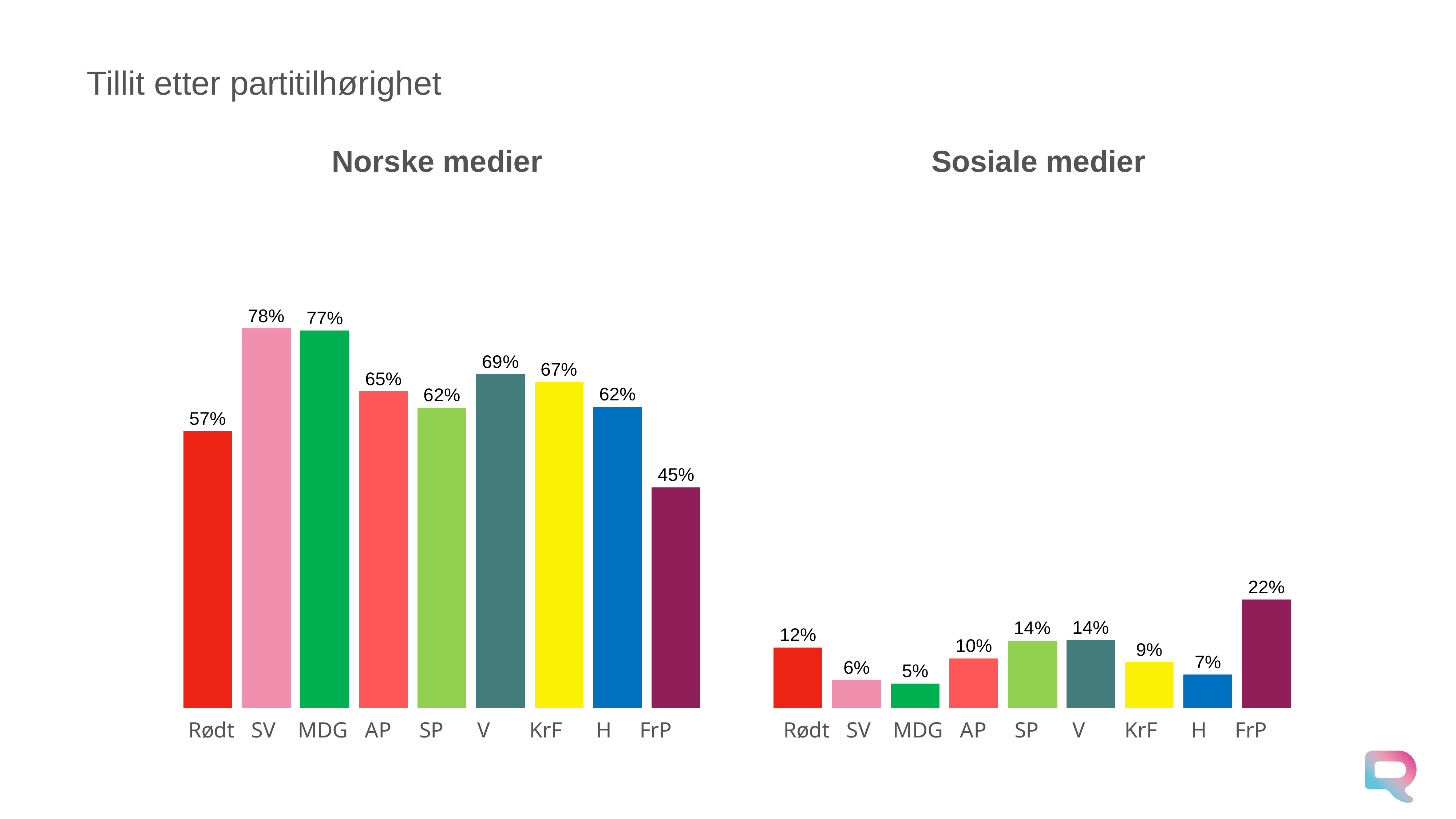
In the Sosiale medier chart, which party has the highest value? FrP What is the title of the slide? Tillit etter partitilhørighet In the Sosiale medier chart, what is the difference between the values for FrP and Rødt? 10% In the Norske medier chart, which party has the lowest value? FrP In the Sosiale medier chart, what is the value for FrP? 22% In the Norske medier chart, which is larger, the value for V or the value for AP? V In the Norske medier chart, what is the value for SV? 78% In the Sosiale medier chart, which party has the lowest value? MDG What kind of chart is the Norske medier chart? Bar chart In the Norske medier chart, what is the difference between the values for SV and FrP? 33% In the Norske medier chart, which party has the highest value? SV How many parties are shown in the Sosiale medier chart? 9